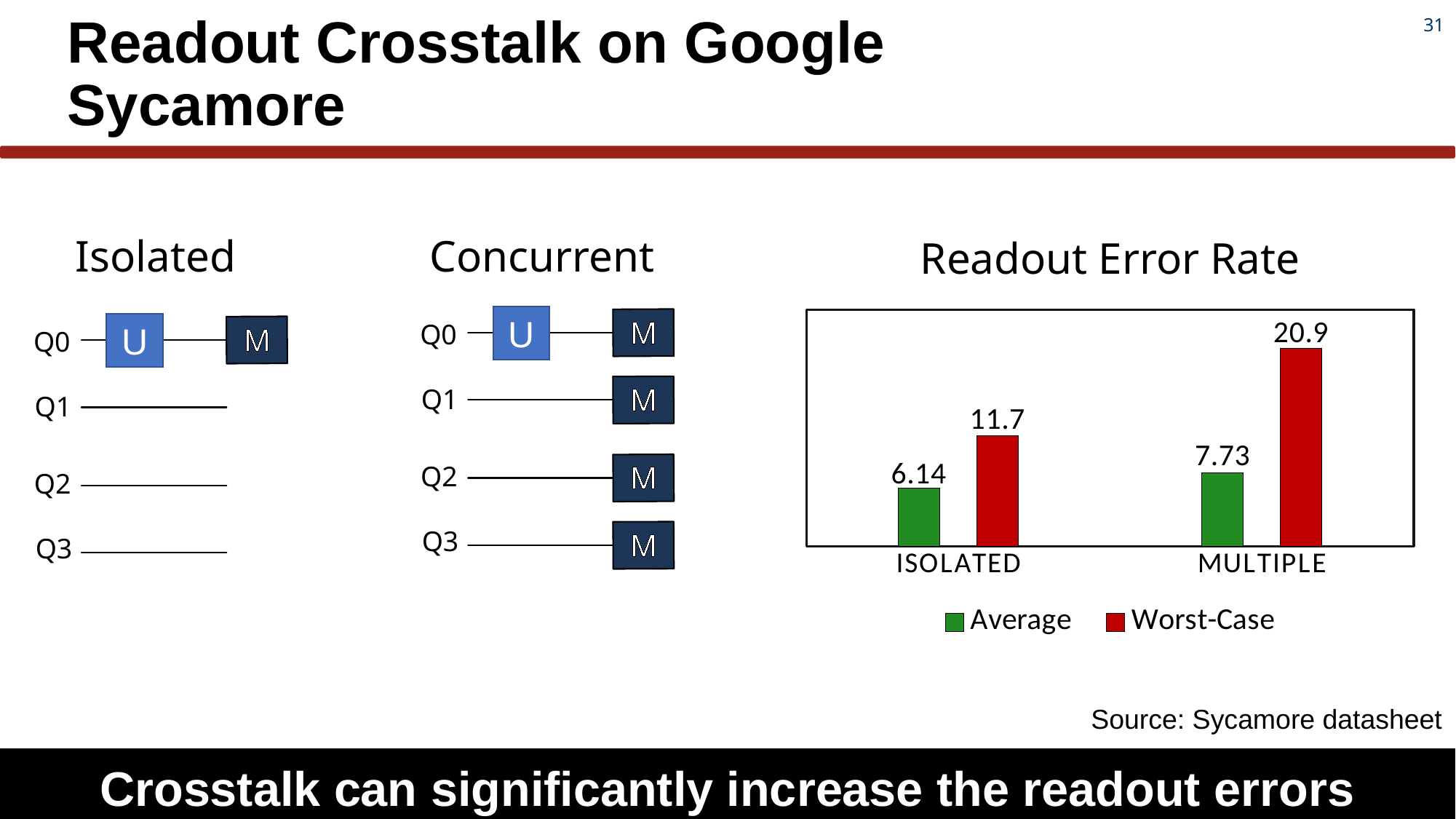
Which is larger: the Average readout error rate for MULTIPLE or the Worst-Case readout error rate for ISOLATED? Worst-Case for ISOLATED What is the Worst-Case readout error rate for ISOLATED? 11.7 What is the difference between the Worst-Case readout error rates for MULTIPLE and ISOLATED? 9.2 Which category has the highest Worst-Case readout error rate? MULTIPLE What colour are the Worst-Case bars in the Readout Error Rate chart? Red What is the Worst-Case readout error rate for MULTIPLE? 20.9 What kind of chart is the Readout Error Rate chart? Bar chart Which category has the lowest Average readout error rate? ISOLATED How many series does the legend of the Readout Error Rate chart list? 2 What is the Average readout error rate for ISOLATED? 6.14 How many categories are shown on the x axis of the Readout Error Rate chart? 2 What is the Average readout error rate for MULTIPLE? 7.73